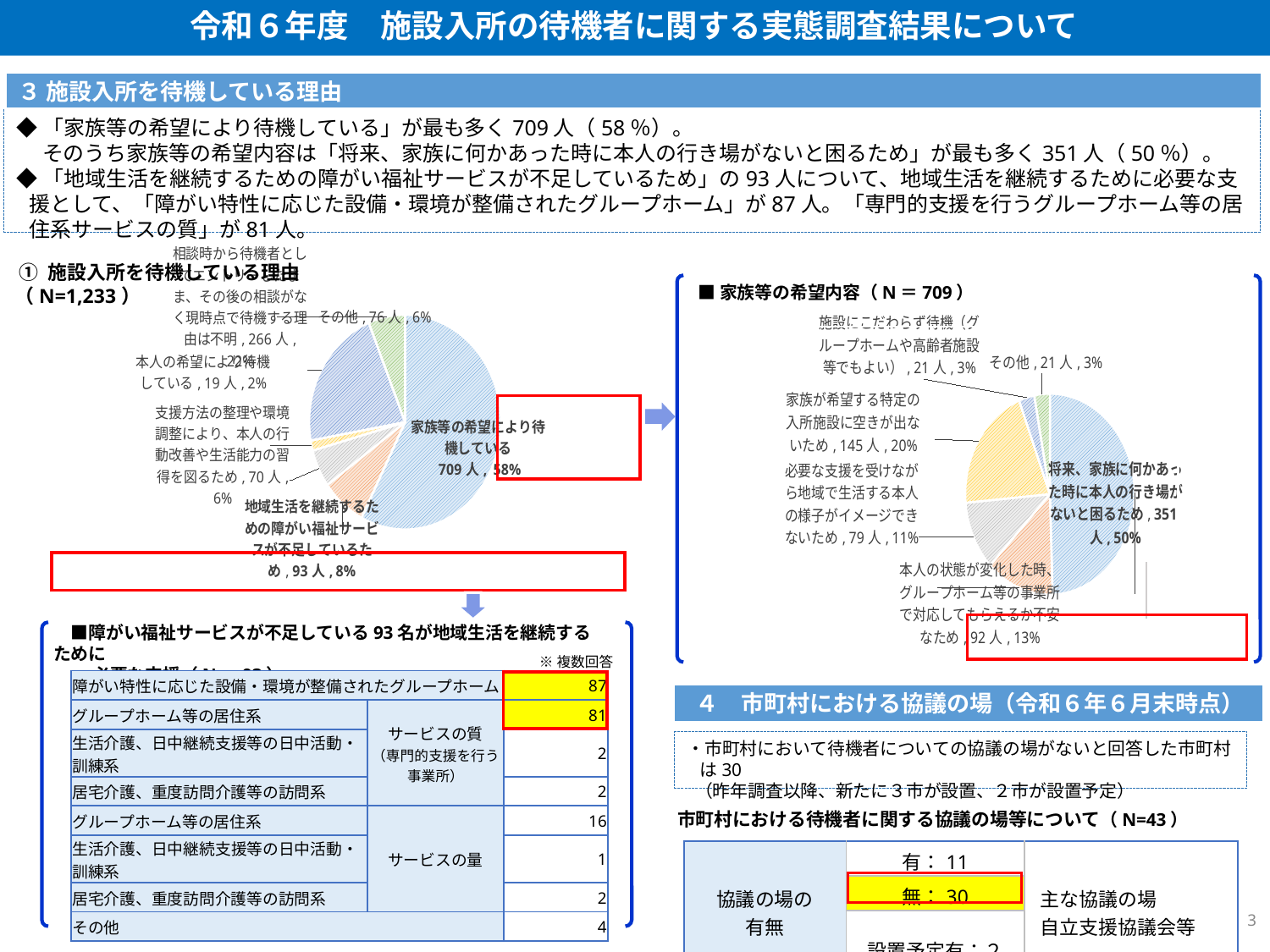
In the pie chart titled 施設入所を待機している理由 (N=1,233), how many people are in the 家族等の希望により待機している slice? 709 人 How many slices does the pie chart titled 家族等の希望内容 (N=709) have? 6 In the pie chart titled 施設入所を待機している理由, how many people are in the 地域生活を継続するための障がい福祉サービスが不足しているため slice? 93 人 In the pie chart titled 施設入所を待機している理由, which category has the largest slice? 家族等の希望により待機している In the pie chart titled 家族等の希望内容, how many people are in the その他 slice? 21 人 In the pie chart titled 施設入所を待機している理由, what is the difference in people between 家族等の希望により待機している and 地域生活を継続するための障がい福祉サービスが不足しているため? 616 人 In the pie chart titled 家族等の希望内容, what percentage share does 家族が希望する特定の入所施設に空きが出ないため have? 20% In the pie chart titled 施設入所を待機している理由, what percentage share does 家族等の希望により待機している have? 58% In the pie chart titled 家族等の希望内容, which is larger: 本人の状態が変化した時、グループホーム等の事業所で対応してもらえるか不安なため or 必要な支援を受けながら地域で生活する本人の様子がイメージできないため? 本人の状態が変化した時、グループホーム等の事業所で対応してもらえるか不安なため In the pie chart titled 施設入所を待機している理由, which category has the smallest slice? 本人の希望により待機している In the pie chart titled 家族等の希望内容 (N=709), how many people chose 将来、家族に何かあった時に本人の行き場がないと困るため? 351 人 What kind of chart is used for 家族等の希望内容 (N=709)? Pie chart